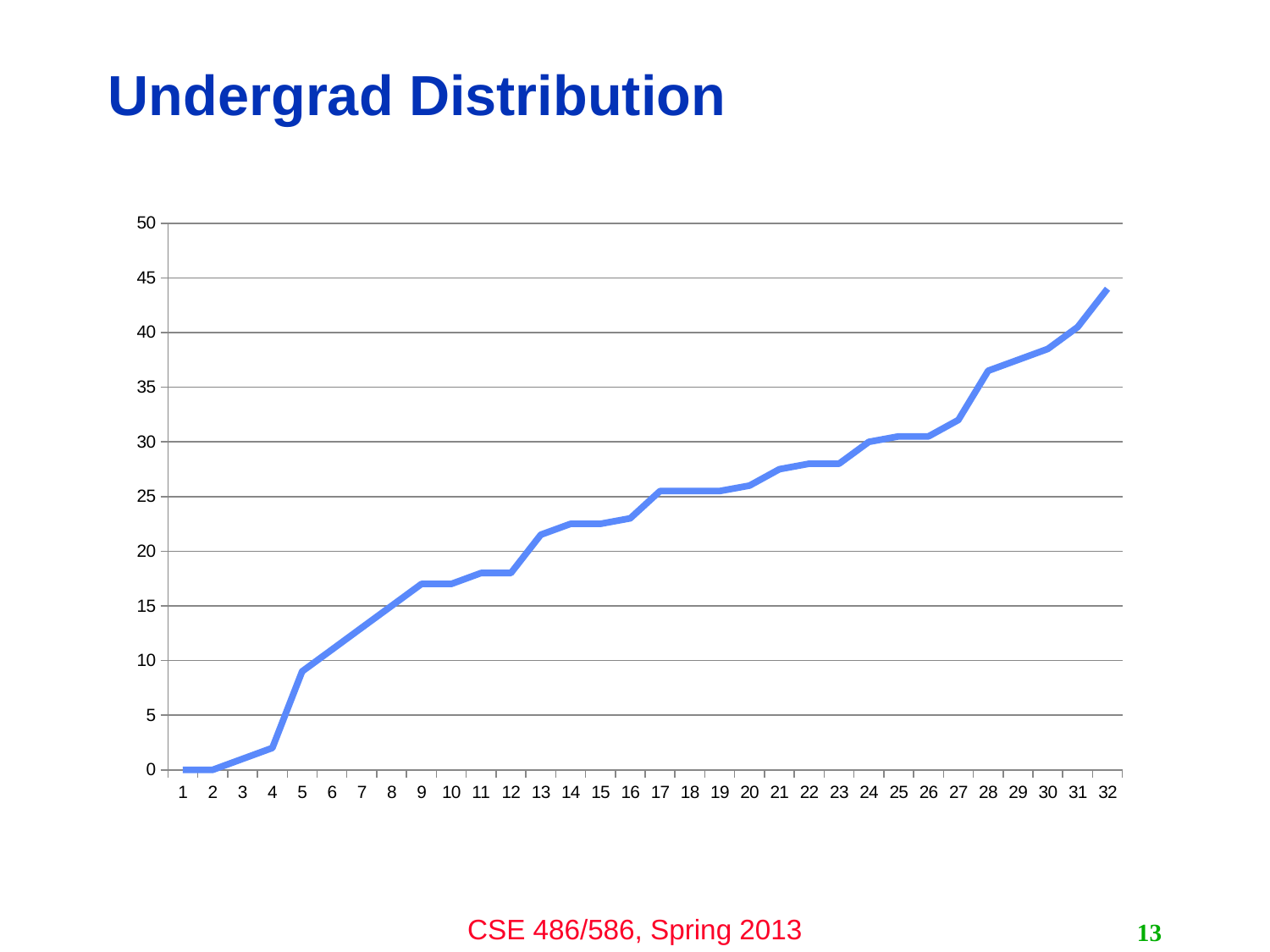
Is the value at point 20 greater or less than 30? less Is the value at point 9 greater or less than 15? greater What kind of chart is shown on the slide? line chart Which has the larger value, point 10 or point 6? point 10 Which point on the x axis has the highest value? 32 What is the value at point 1? 0 Is the value at point 5 greater or less than 10? less What is the title of the slide containing the chart? Undergrad Distribution Do the values rise or fall as you move from left to right along the x axis? rise How many points are plotted along the x axis? 32